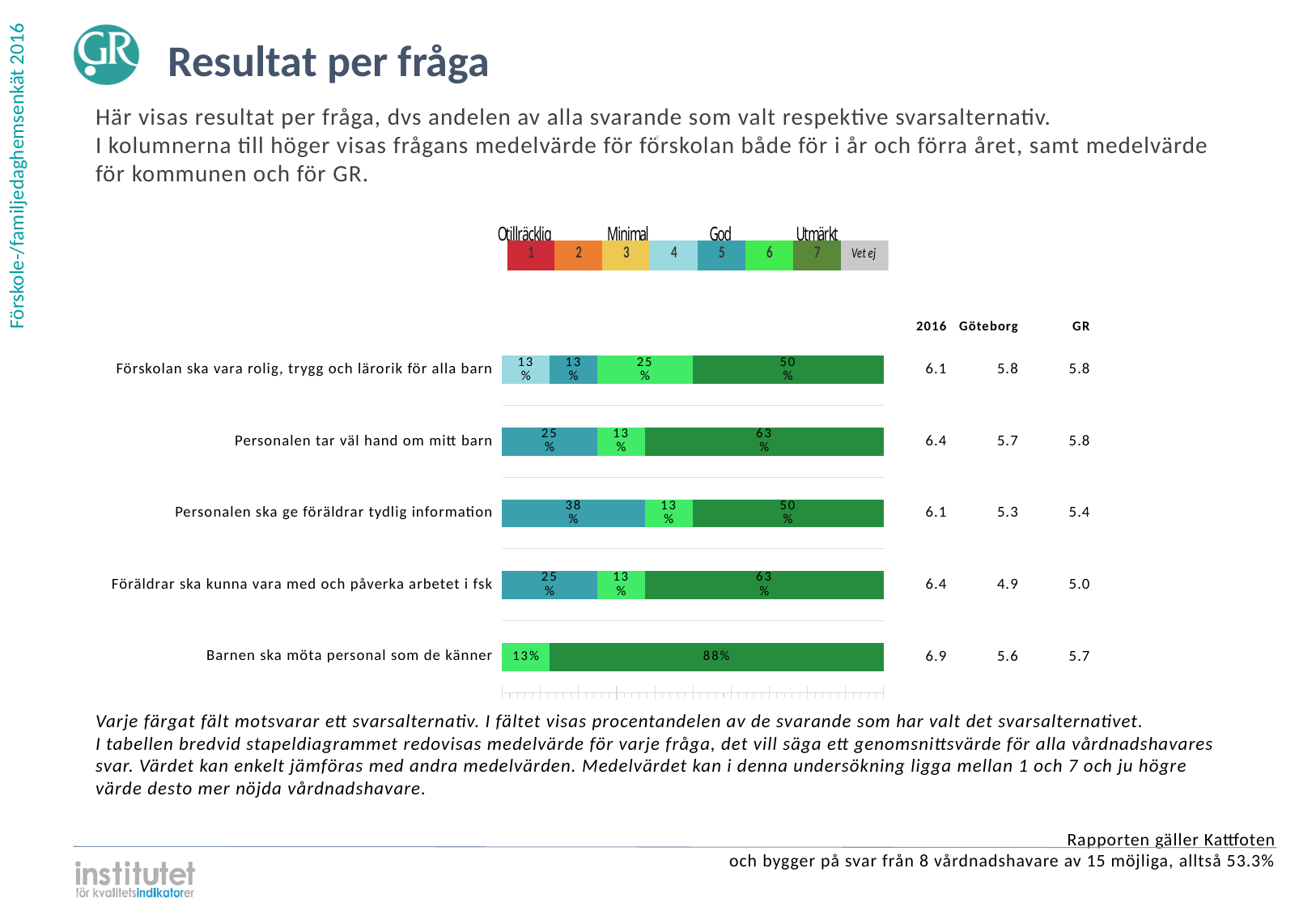
What percentage of respondents chose answer 7 (dark green) for 'Personalen tar väl hand om mitt barn'? 63% What is the 2016 mean value shown for 'Barnen ska möta personal som de känner'? 6.9 Which question has the smallest share of respondents choosing answer 7 (dark green)? Förskolan ska vara rolig, trygg och lärorik för alla barn and Personalen ska ge föräldrar tydlig information (both 50%) What is the Göteborg mean value shown for 'Föräldrar ska kunna vara med och påverka arbetet i fsk'? 4.9 What percentage of respondents chose answer 7 (dark green) for 'Barnen ska möta personal som de känner'? 88% Which is larger: the answer 5 (teal) share for 'Personalen ska ge föräldrar tydlig information' or for 'Personalen tar väl hand om mitt barn'? Personalen ska ge föräldrar tydlig information Which question has the largest share of respondents choosing answer 7 (dark green)? Barnen ska möta personal som de känner What kind of chart is shown on the slide? Stacked bar chart How many questions (categories) are plotted in the bar chart? 5 How many answer alternatives does the legend above the chart list? 8 What percentage of respondents chose answer 5 (teal) for 'Personalen ska ge föräldrar tydlig information'? 38% What is the difference in percentage points between the answer 7 share for 'Barnen ska möta personal som de känner' (88%) and for 'Förskolan ska vara rolig, trygg och lärorik för alla barn' (50%)? 38 percentage points